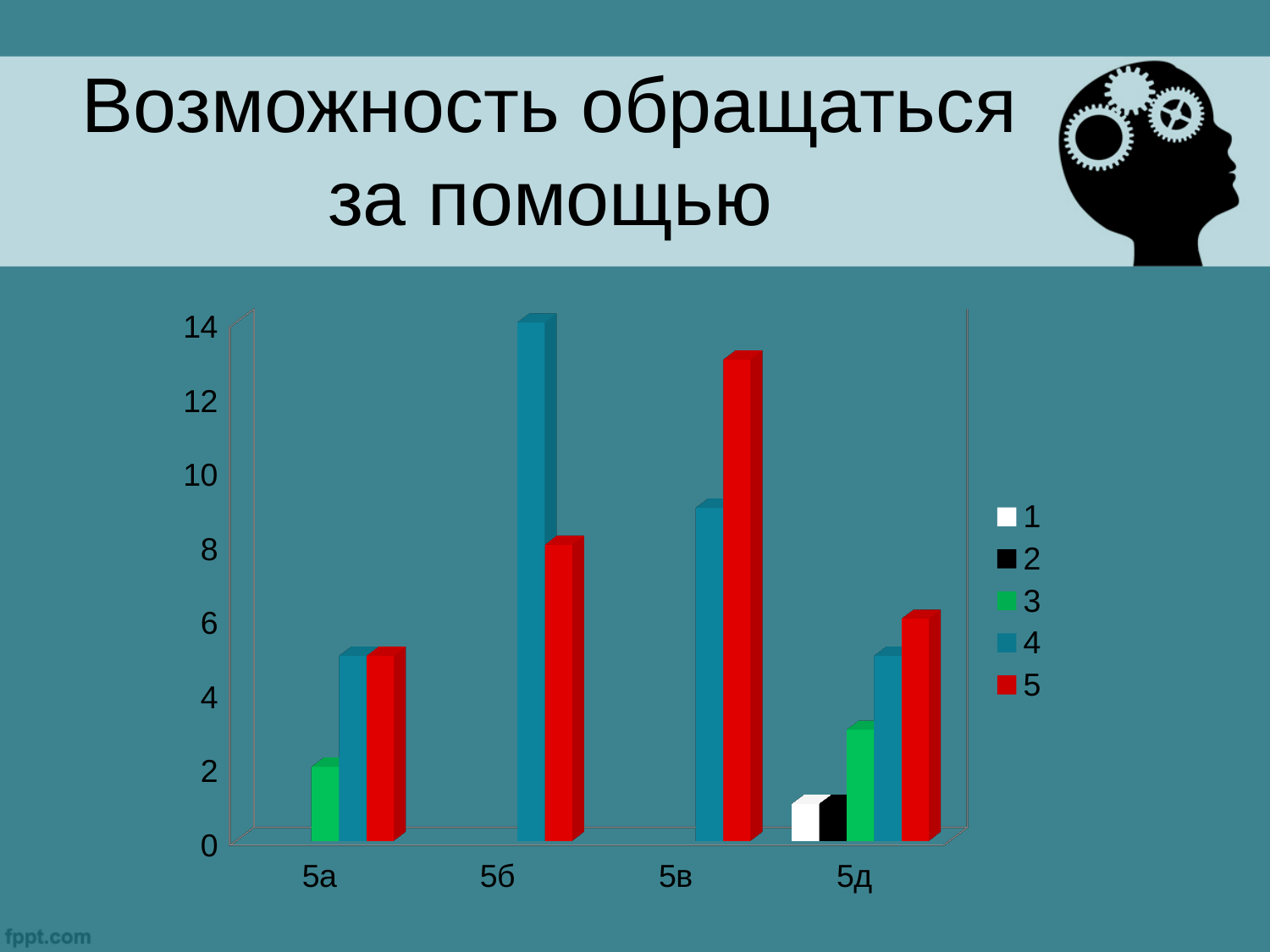
What colour represents series 5 in the legend? red What kind of chart is shown on the slide? bar chart Which category has the highest value for series 4? 5б Is the value of series 5 for 5б greater or less than 10? less Is the value of series 5 for 5в greater or less than 12? greater How many series does the legend list? 5 For category 5в, which is larger: series 4 or series 5? series 5 For category 5б, which is larger: series 4 or series 5? series 4 How many categories are shown on the x axis? 4 Is the value of series 3 for 5д greater or less than 4? less What is the value of series 4 for category 5б? 14 Which category has the highest value for series 5? 5в